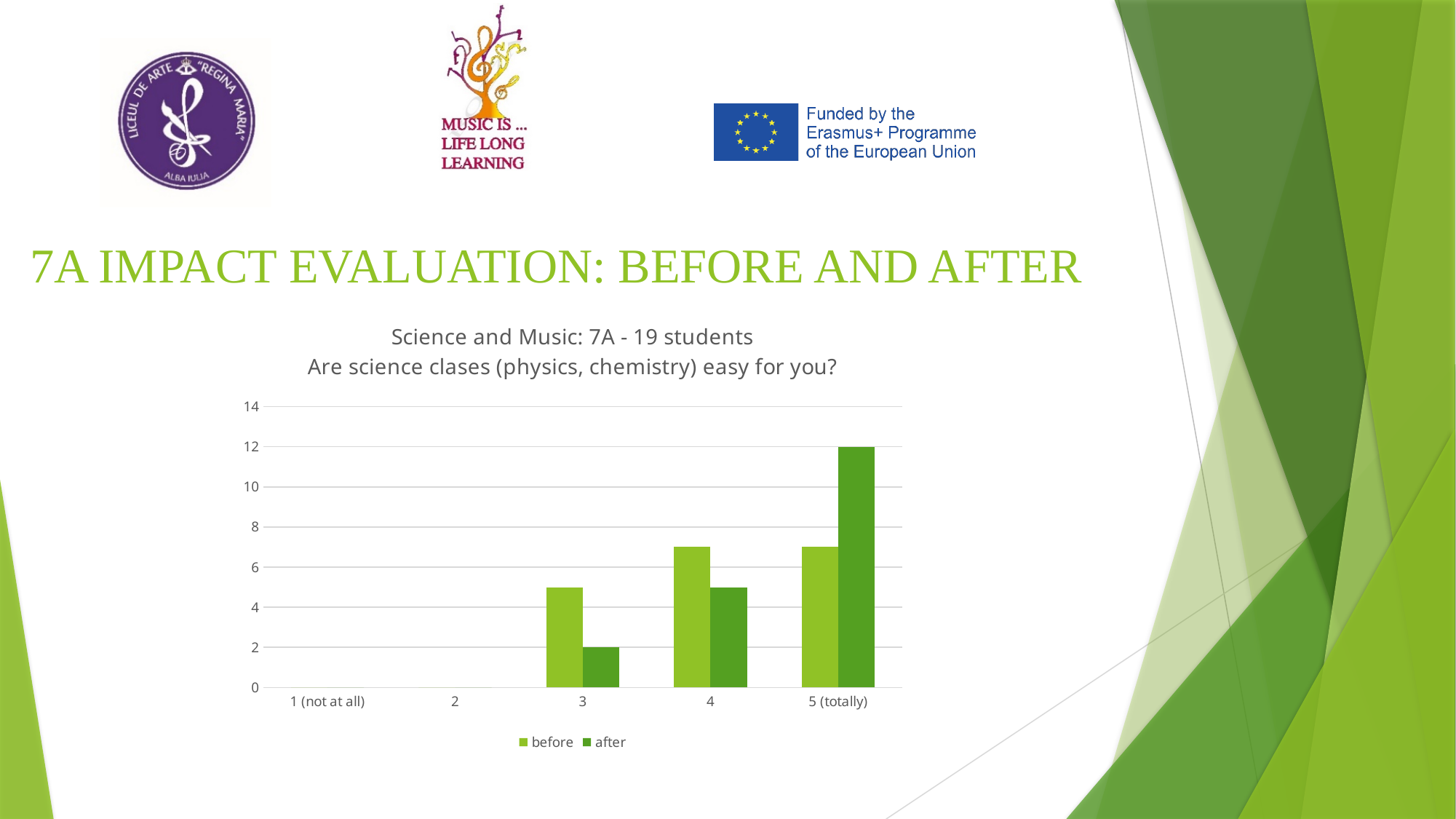
What is the 'after' value for the category '3'? 2 What kind of chart is shown on the slide? bar chart Is the 'before' value for the category '3' greater or less than 6? less Is the 'before' value for the category '4' greater or less than 6? greater How many series does the legend list? 2 What is the difference between the 'after' value for '5 (totally)' and the 'after' value for '3'? 10 What is the 'after' value for the category '5 (totally)'? 12 For the category '3', which is larger, the 'before' value or the 'after' value? before For the category '5 (totally)', which is larger, the 'before' value or the 'after' value? after How many categories are shown on the x axis? 5 What are the two entries listed in the legend? before, after Which category has the highest 'after' value? 5 (totally)